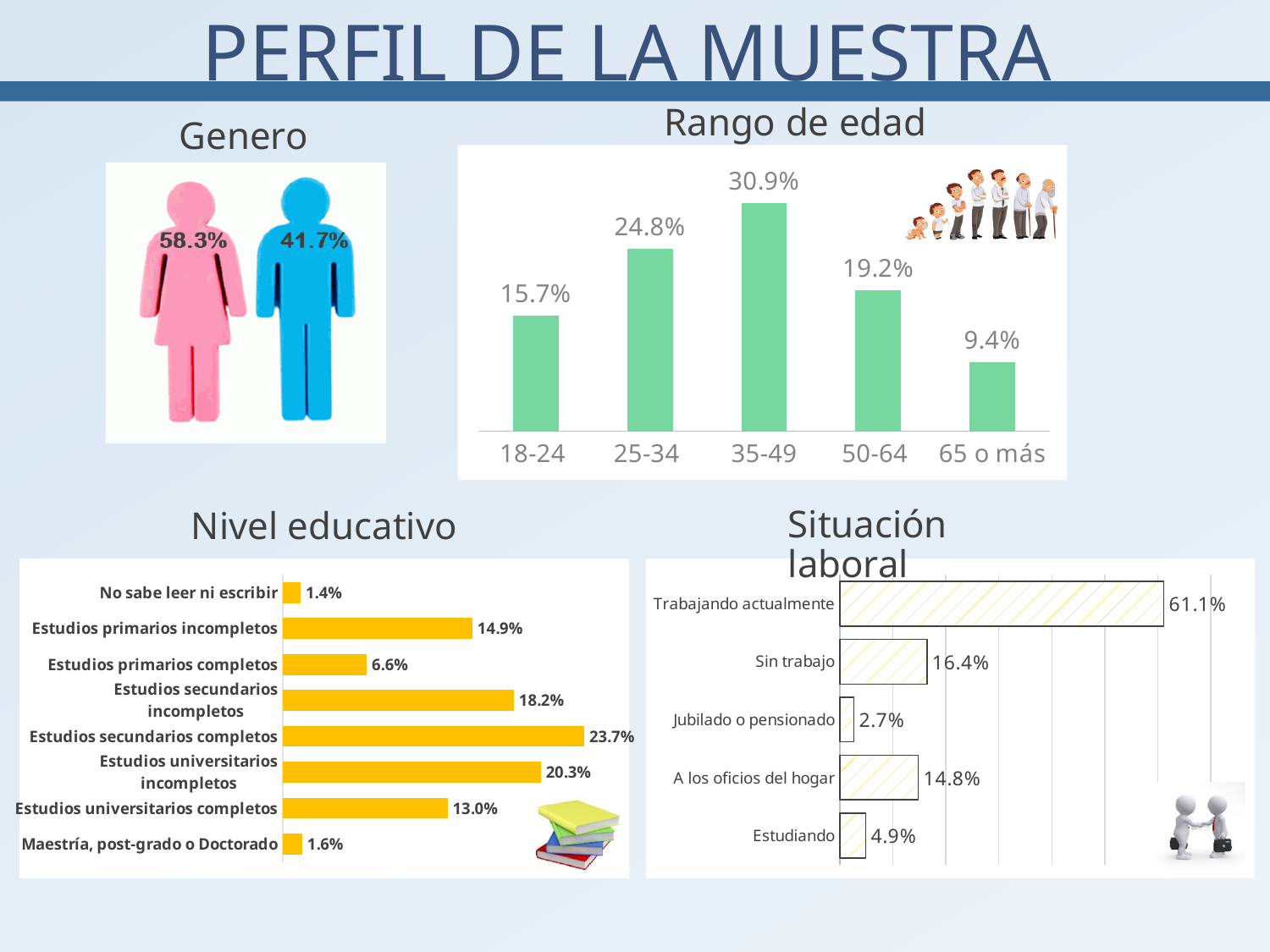
In the 'Nivel educativo' chart, which category has the lowest value? No sabe leer ni escribir In the 'Nivel educativo' chart, which is larger: 'Estudios primarios incompletos' or 'Estudios universitarios completos'? Estudios primarios incompletos In the 'Nivel educativo' chart, how many categories are shown? 8 In the 'Rango de edad' chart, what is the value for the 35-49 age group? 30.9% In the 'Rango de edad' chart, how many age groups are shown? 5 In the 'Nivel educativo' chart, what is the value for 'Estudios secundarios completos'? 23.7% In the 'Situación laboral' chart, what is the value for 'Sin trabajo'? 16.4% What kind of chart is the 'Nivel educativo' chart? Bar chart In the 'Situación laboral' chart, which category has the highest value? Trabajando actualmente In the 'Rango de edad' chart, which age group has the lowest value? 65 o más In the 'Situación laboral' chart, what is the difference between 'A los oficios del hogar' and 'Estudiando'? 9.9% In the 'Rango de edad' chart, what is the difference between the 25-34 and 18-24 values? 9.1%